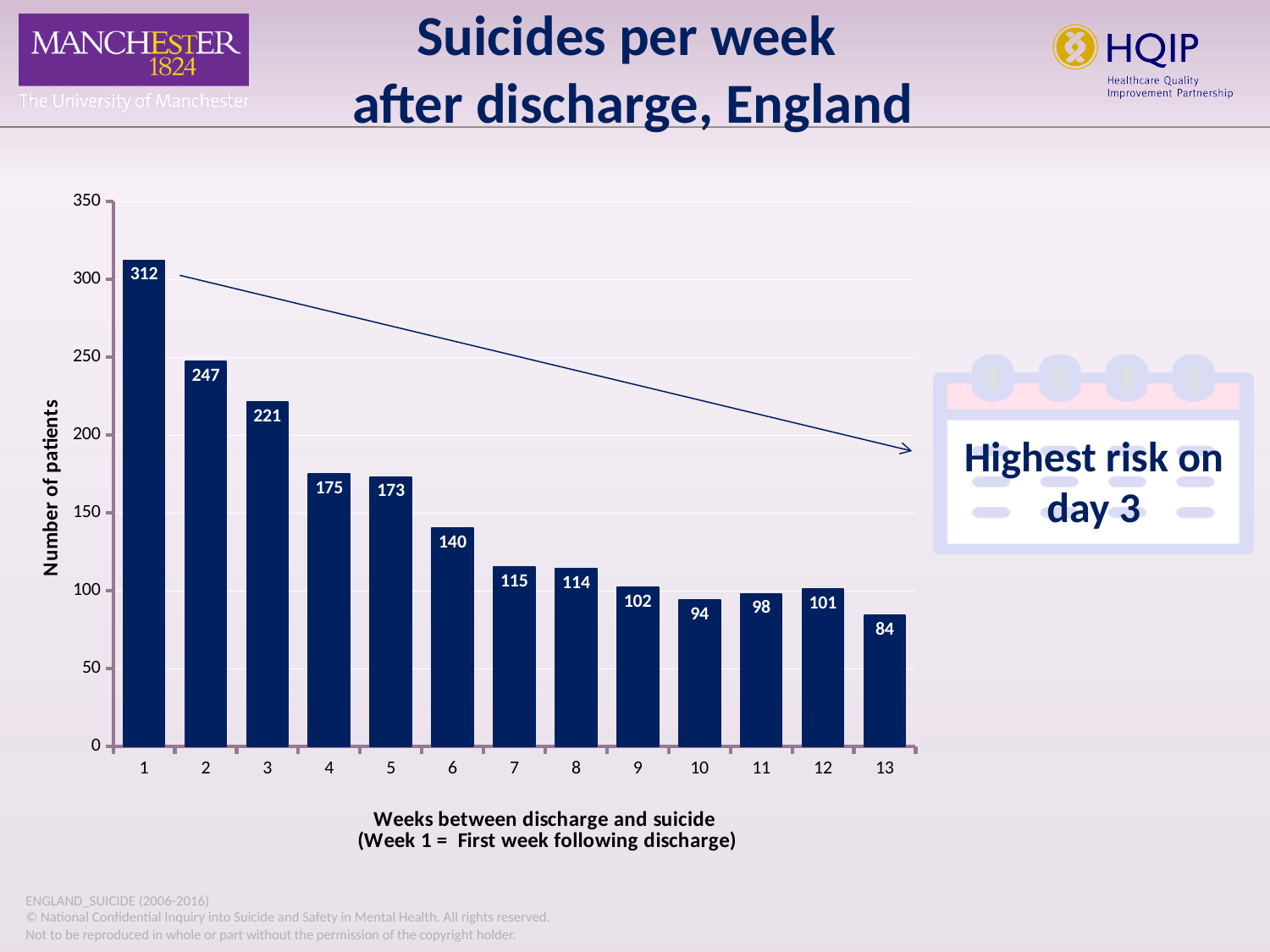
What is the number of patients for week 13? 84 Is the value for week 4 greater or less than 150? greater What is the number of patients for week 1? 312 Which has more patients, week 9 or week 10? week 9 What is the difference in number of patients between week 1 and week 2? 65 Which week has the highest number of patients? 1 Which week has the lowest number of patients? 13 What kind of chart is shown on the slide? bar chart How many weeks are shown on the x axis? 13 What is the number of patients for week 6? 140 Do the values generally rise or fall from week 1 to week 13? fall What is the difference in number of patients between week 3 and week 13? 137